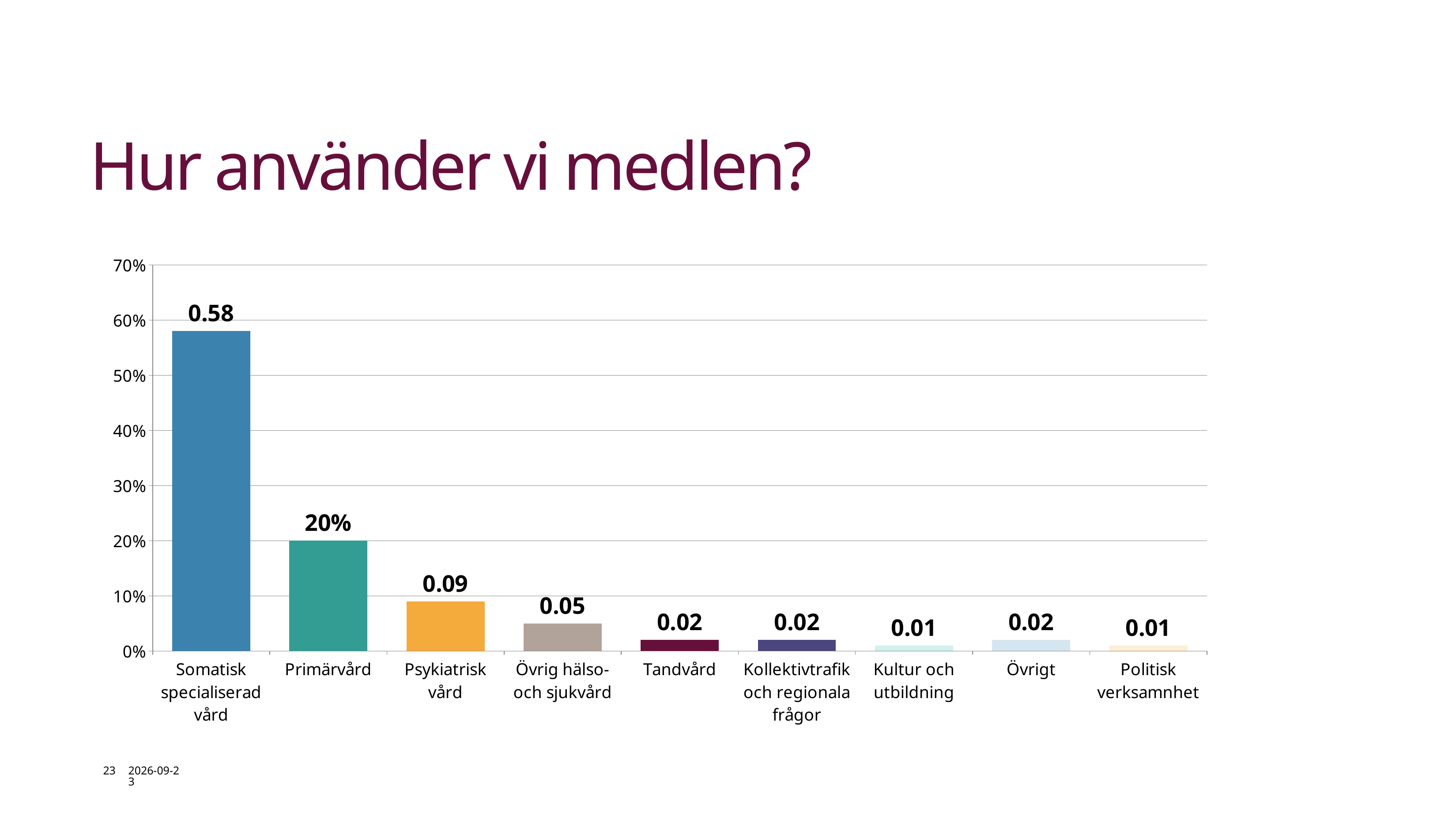
Is the value for Psykiatrisk vård greater or less than 10%? less What is the data label shown for Somatisk specialiserad vård? 0.58 What kind of chart is shown on the slide? Bar chart What is the title of the slide? Hur använder vi medlen? How many categories are shown on the x axis? 9 Which category has the highest bar? Somatisk specialiserad vård Is the value for Somatisk specialiserad vård greater or less than 50%? greater What is the data label shown for Kultur och utbildning? 0.01 What is the data label shown for Övrig hälso- och sjukvård? 0.05 Which bar is taller, Psykiatrisk vård or Tandvård? Psykiatrisk vård What is the data label shown for Psykiatrisk vård? 0.09 What is the data label shown for Primärvård? 20%